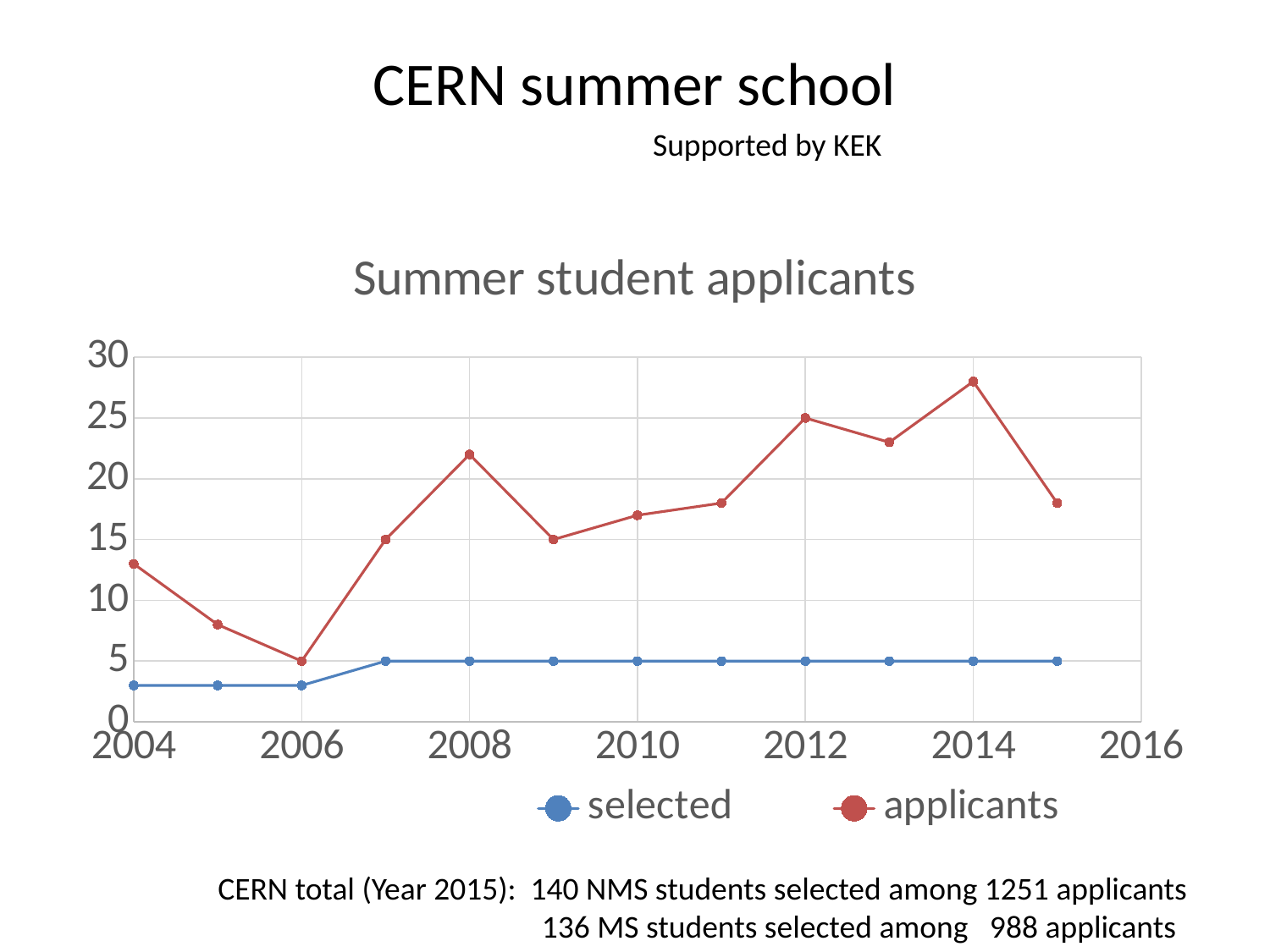
Is the number of applicants in 2014 greater or less than 25? greater Which year had more applicants, 2008 or 2009? 2008 What are the two series named in the legend? selected and applicants What is the title of the chart? Summer student applicants What kind of chart is shown on the slide? line chart What is the value of the selected series in 2010? 5 Is the number of applicants in 2005 greater or less than 10? less In which year was the number of applicants highest? 2014 How many series does the legend list? 2 In which year was the number of applicants lowest? 2006 What is the value of the applicants series in 2012? 25 How many years have data points plotted for the applicants series? 12